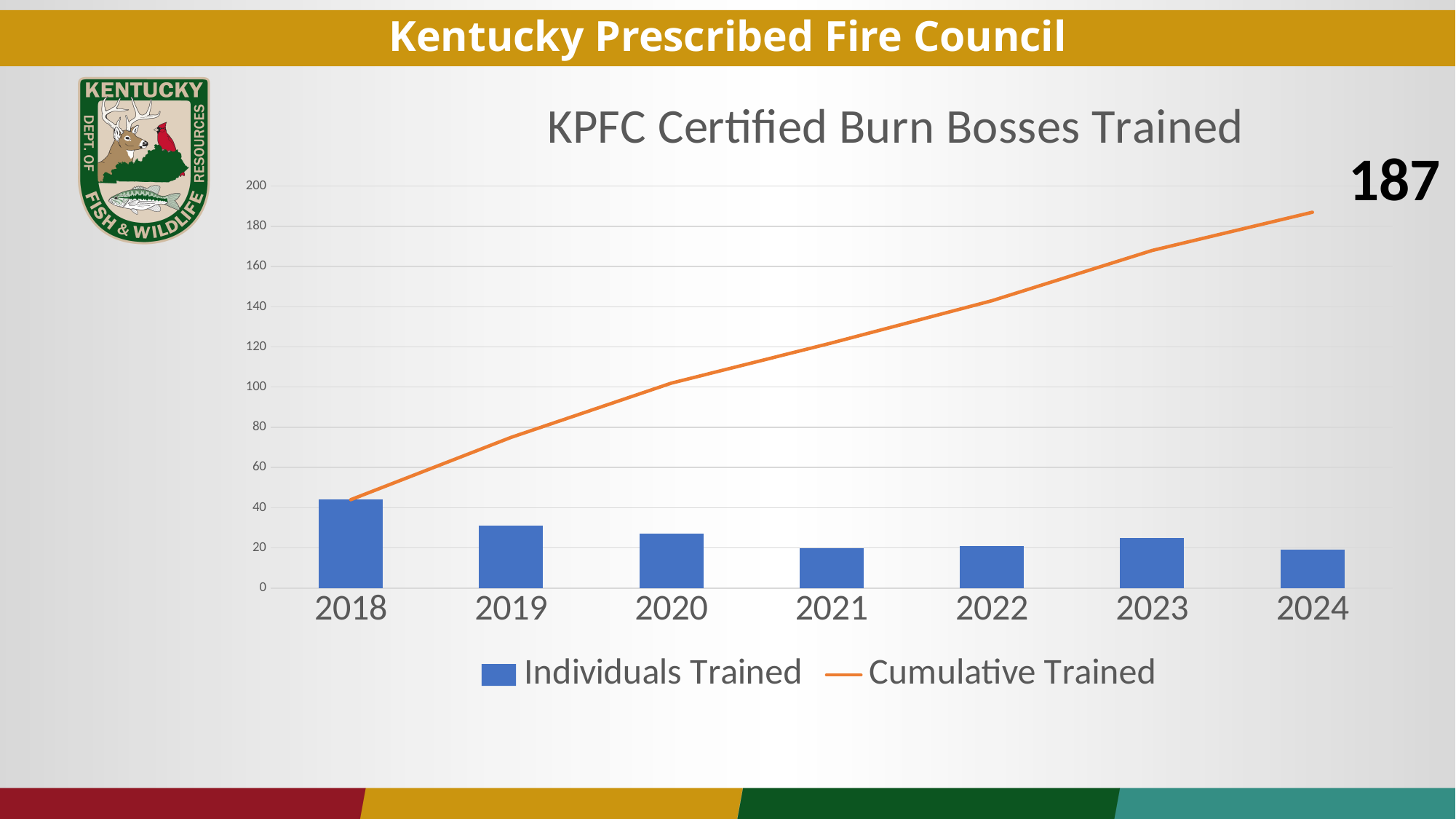
How many years are shown on the x axis? 7 Is the Individuals Trained value for 2021 greater or less than 40? less Which year has the highest number of Individuals Trained? 2018 What is the Cumulative Trained value labelled at the end of the line in 2024? 187 Is the Individuals Trained value for 2018 greater or less than 40? greater Which year has more Individuals Trained, 2018 or 2019? 2018 What kind of chart is shown on the slide? A combined bar and line chart What are the two series named in the legend? Individuals Trained and Cumulative Trained Is the Individuals Trained value for 2019 greater or less than 20? greater How many series does the legend list? 2 What is the title of the chart? KPFC Certified Burn Bosses Trained Does the Cumulative Trained line rise or fall from 2018 to 2024? rise